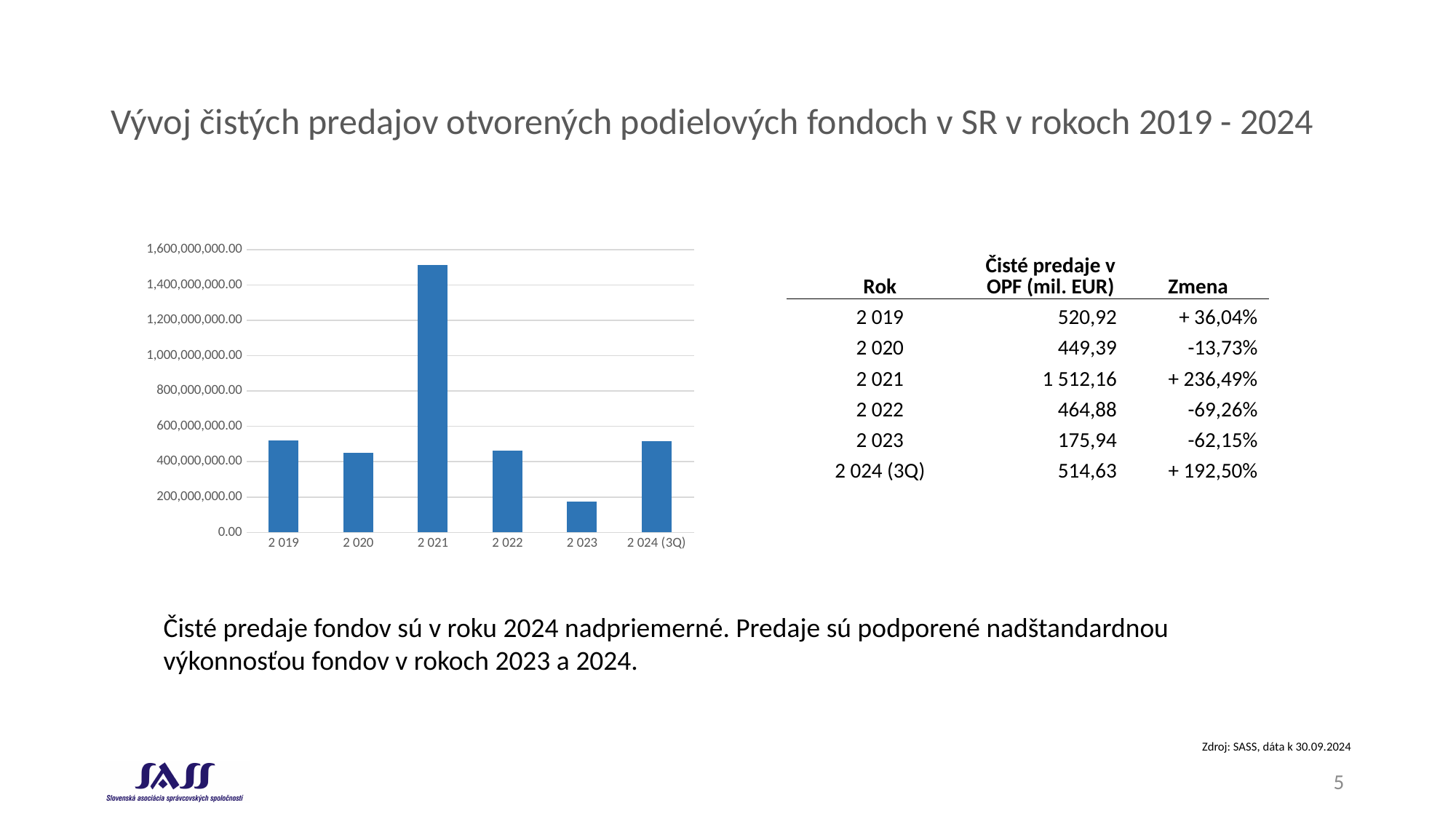
What kind of chart is shown on the slide? bar chart Is the value for 2 023 in the chart greater or less than 200,000,000.00? less Do the values in the chart rise or fall from 2 021 to 2 023? fall What is the title of the slide containing the chart? Vývoj čistých predajov otvorených podielových fondoch v SR v rokoch 2019 - 2024 According to the table next to the chart, what is the Zmena value for 2 024 (3Q)? + 192,50% Which is larger in the chart, the value for 2 021 or the value for 2 022? 2 021 According to the table next to the chart, what are the net sales (Čisté predaje v OPF) for 2 021 in mil. EUR? 1 512,16 Is the value for 2 021 in the chart greater or less than 1,400,000,000.00? greater Which year has the lowest bar in the chart? 2 023 Which year has the highest bar in the chart? 2 021 How many years (bars) are shown in the chart? 6 Is the value for 2 020 in the chart greater or less than 400,000,000.00? greater